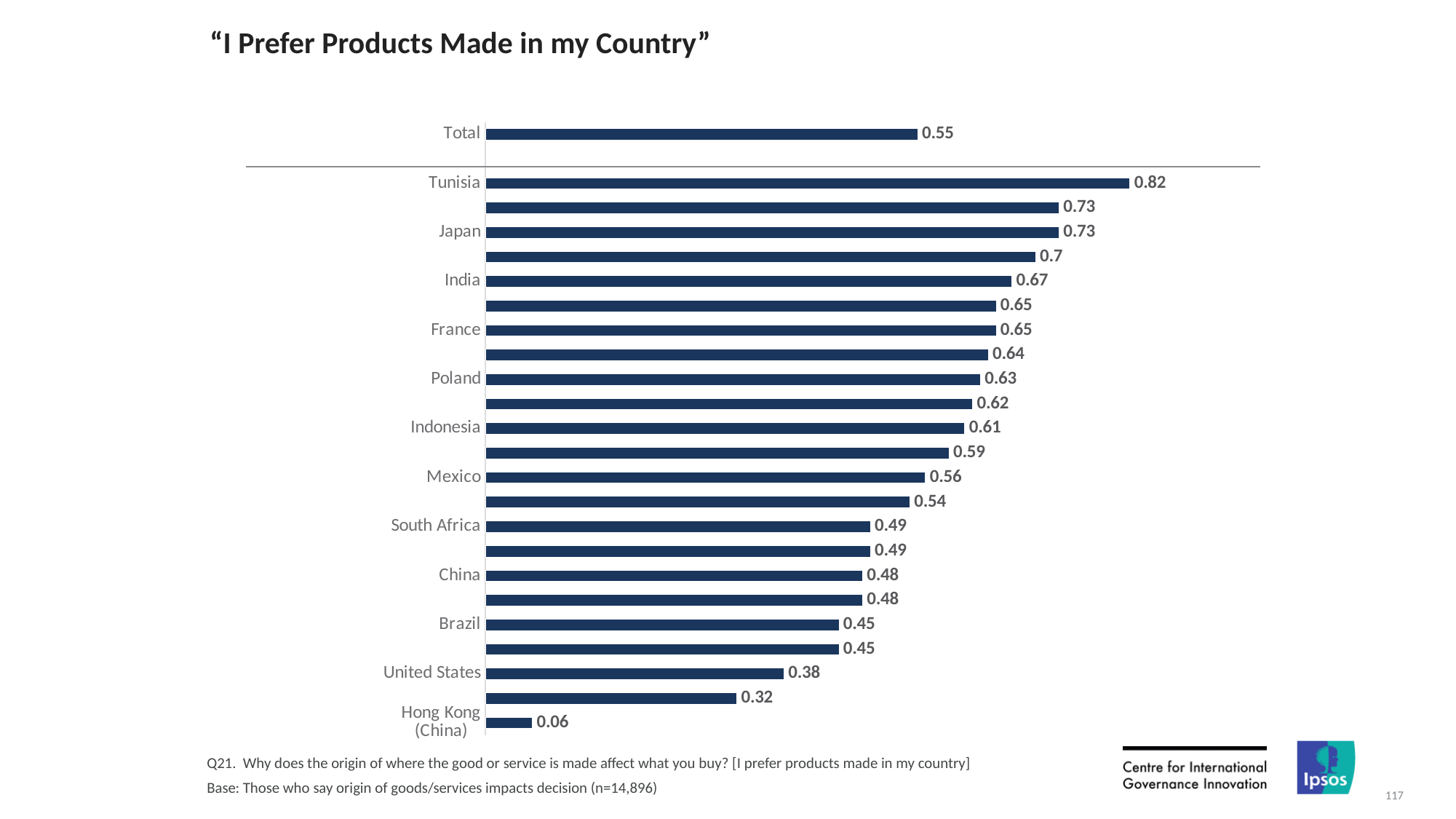
What is the value for Indonesia? 0.61 Which country has the highest value? Tunisia Which has a larger value, Mexico or Brazil? Mexico Which country has the lowest value? Hong Kong (China) What kind of chart is shown on the slide? Bar chart What is the value for the United States? 0.38 What is the title of the chart? "I Prefer Products Made in my Country" What is the value for Hong Kong (China)? 0.06 What is the value for Total? 0.55 What is the difference between the values for Japan and India? 0.06 What is the value for Tunisia? 0.82 What is the difference between the values for Tunisia and Hong Kong (China)? 0.76